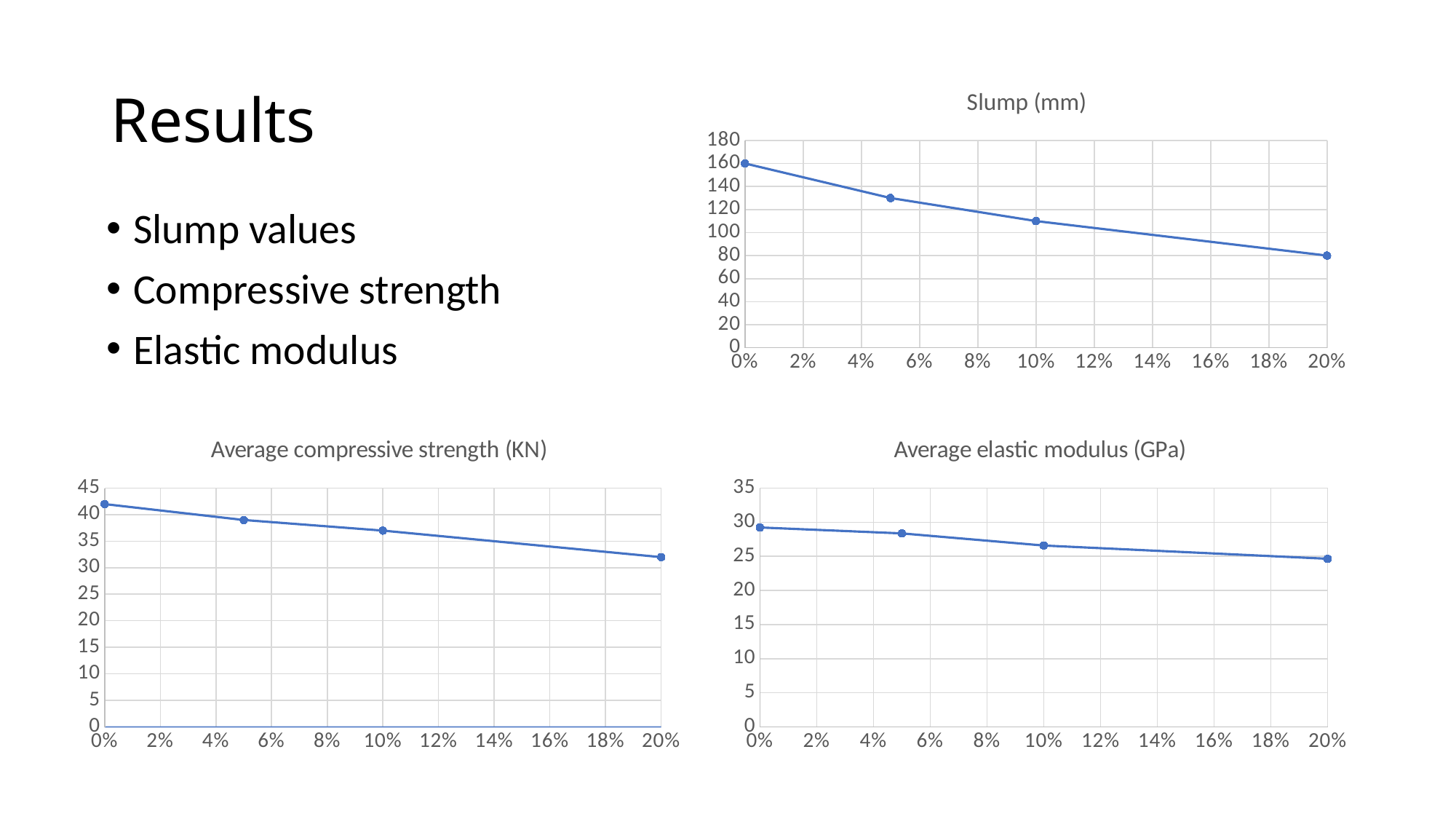
In the 'Slump (mm)' chart, is the value at 0% greater or less than 140? greater In the 'Slump (mm)' chart, do the values rise or fall as the percentage on the x axis increases? fall In the 'Slump (mm)' chart, at which percentage is the slump highest? 0% How many data points are plotted in the 'Slump (mm)' chart? 4 In the 'Average compressive strength (KN)' chart, is the value at 0% greater or less than 40? greater How many charts are shown on the slide? 3 In the 'Average compressive strength (KN)' chart, which is larger, the value at 5% or the value at 20%? 5% What kind of chart is the 'Slump (mm)' chart? line chart In the 'Average elastic modulus (GPa)' chart, is the value at 20% greater or less than 20? greater In the 'Average compressive strength (KN)' chart, at which percentage is the strength lowest? 20% In the 'Average elastic modulus (GPa)' chart, do the values rise or fall along the x axis? fall